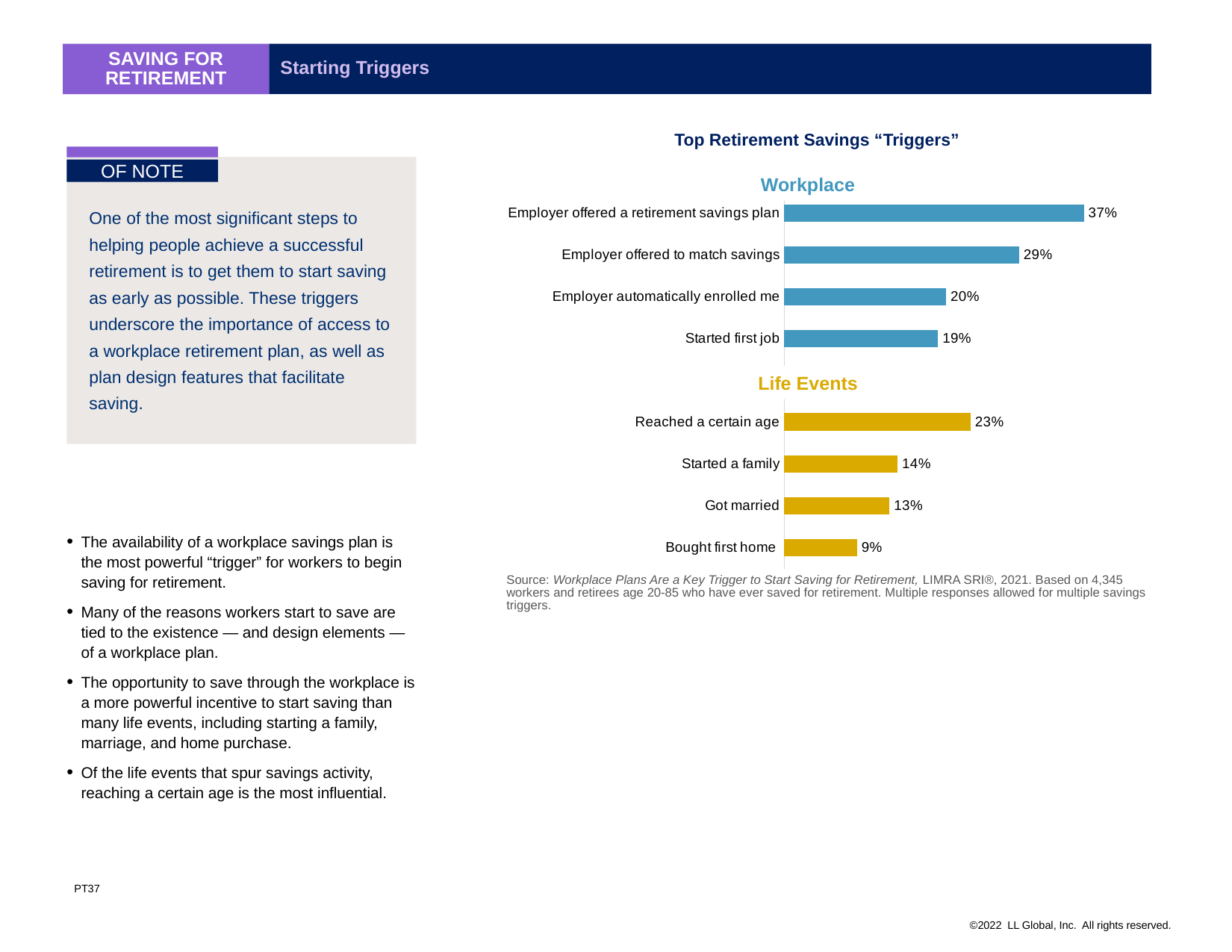
Which Life Events trigger has the highest value? Reached a certain age What is the value for "Started a family"? 14% How many triggers are shown in the Workplace group? 4 What is the difference between "Reached a certain age" and "Bought first home"? 14% What is the difference between "Employer offered a retirement savings plan" and "Employer offered to match savings"? 8% Which trigger has the highest value on the chart? Employer offered a retirement savings plan Which is larger, the value for "Started first job" or the value for "Reached a certain age"? Reached a certain age What is the value for "Employer automatically enrolled me"? 20% What type of chart is shown on the slide? Bar chart Which trigger has the lowest value on the chart? Bought first home What percentage of respondents cited "Employer offered a retirement savings plan" as a trigger? 37% How many triggers are plotted on the chart in total? 8